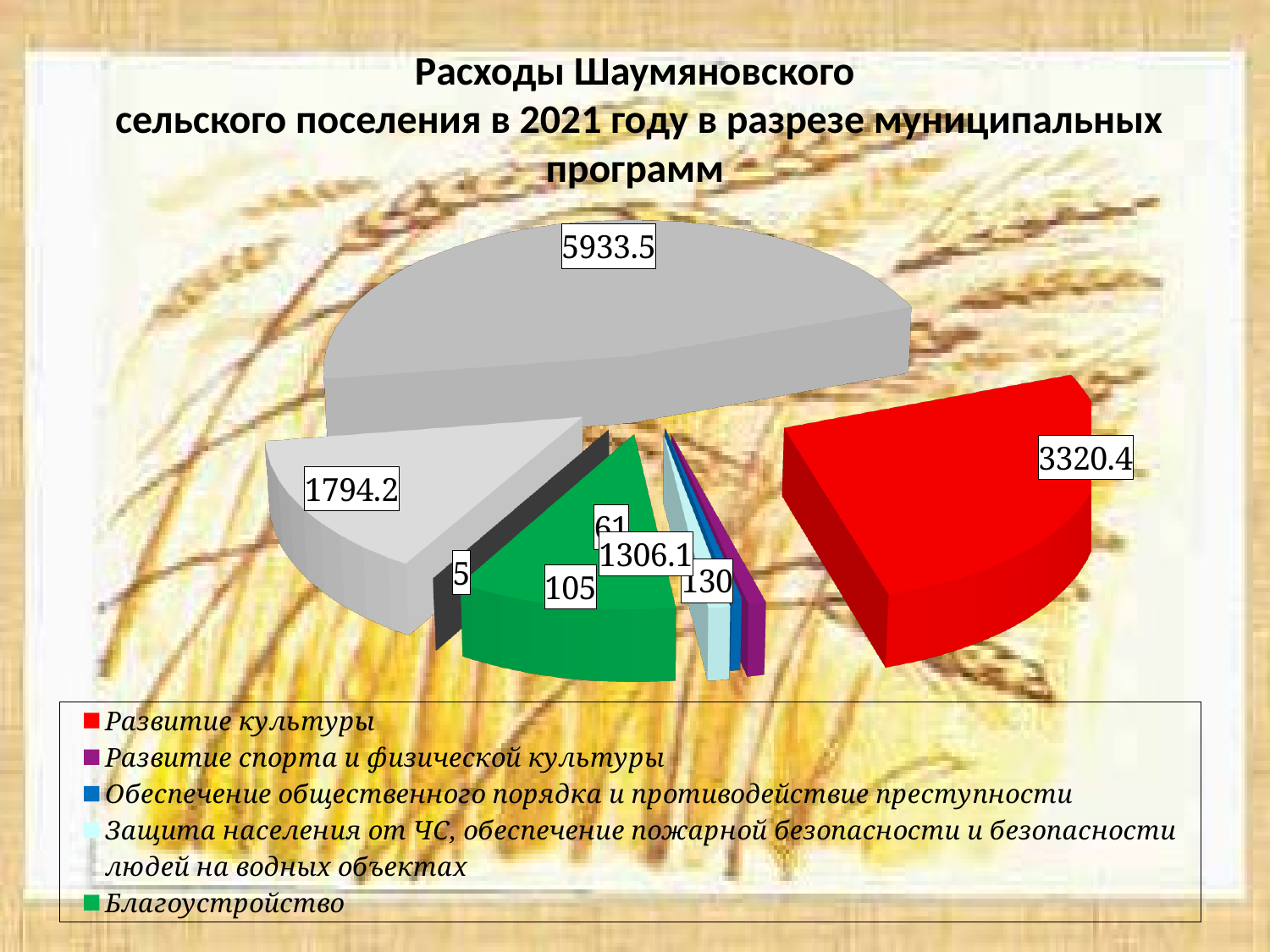
How many data labels are printed on the pie chart? 8 What is the difference between the value for Развитие культуры (3320.4) and the value for Благоустройство (1306.1)? 2014.3 What is the largest value labelled on the pie chart? 5933.5 Which year do the expenditures in the chart title refer to? 2021 What is the smallest value labelled on the pie chart? 5 What colour is the slice for Развитие культуры? red What kind of chart is shown on the slide? pie chart What is the value shown for Благоустройство (the green slice)? 1306.1 What is the value shown for Развитие культуры (the red slice)? 3320.4 Which is larger, the value for Развитие культуры or the value for Благоустройство? Развитие культуры How many entries does the legend list? 5 What is the difference between the largest labelled value (5933.5) and the value for Развитие культуры (3320.4)? 2613.1